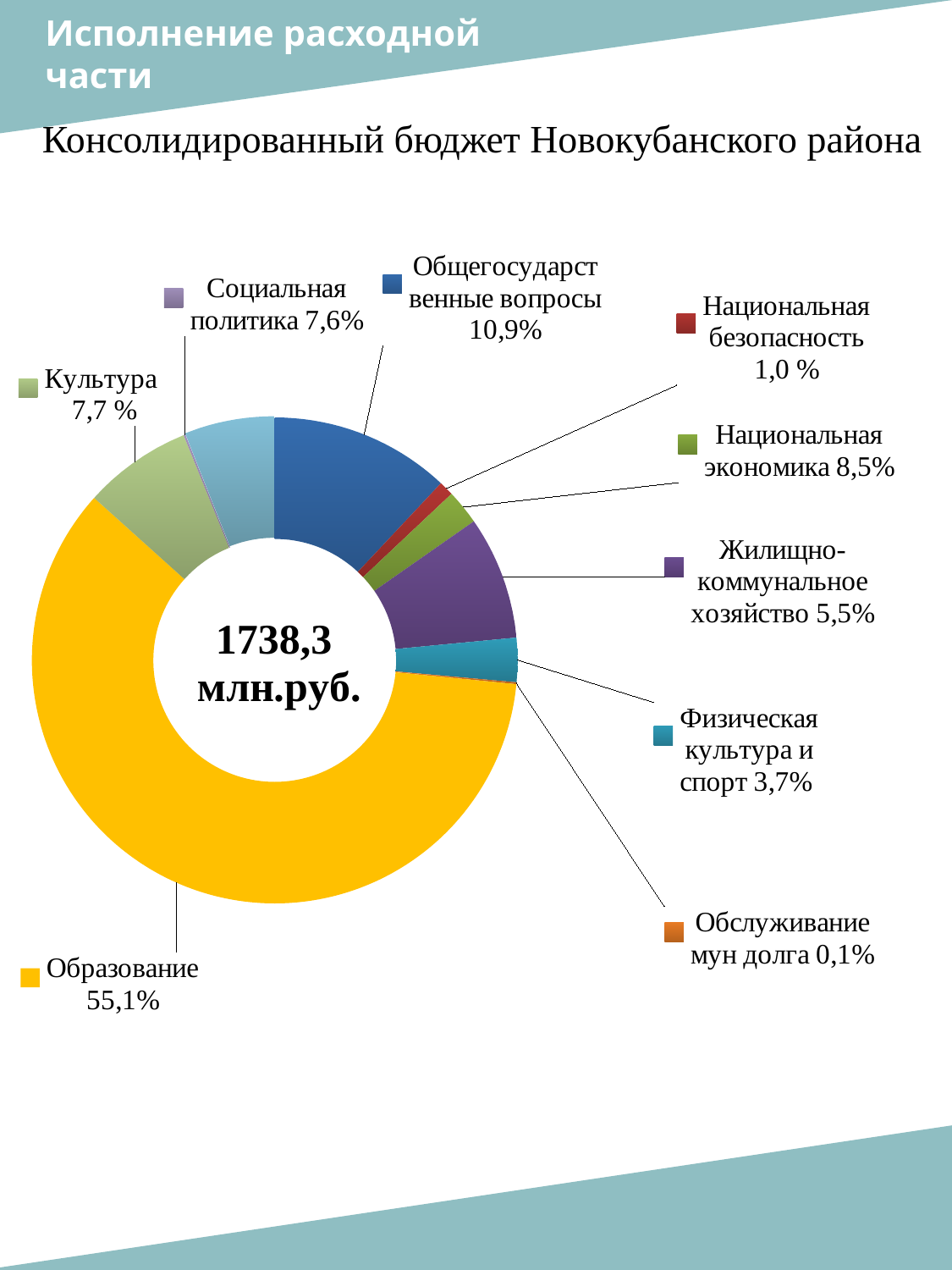
Which is larger: the share for Национальная экономика or the share for Национальная безопасность? Национальная экономика What is the value shown for Национальная экономика? 8,5% What total amount is printed in the centre of the chart? 1738,3 млн.руб. How many categories are shown in the chart? 9 What kind of chart is shown on the slide? Pie (doughnut) chart What is the value shown for Жилищно-коммунальное хозяйство? 5,5% What share of the budget goes to Образование? 55,1% What is the value shown for Физическая культура и спорт? 3,7% Which category has the largest share of the chart? Образование What is the value shown for Общегосударственные вопросы? 10,9% Which category has the smallest share of the chart? Обслуживание мун долга What is the difference in percentage points between Образование and Общегосударственные вопросы? 44,2